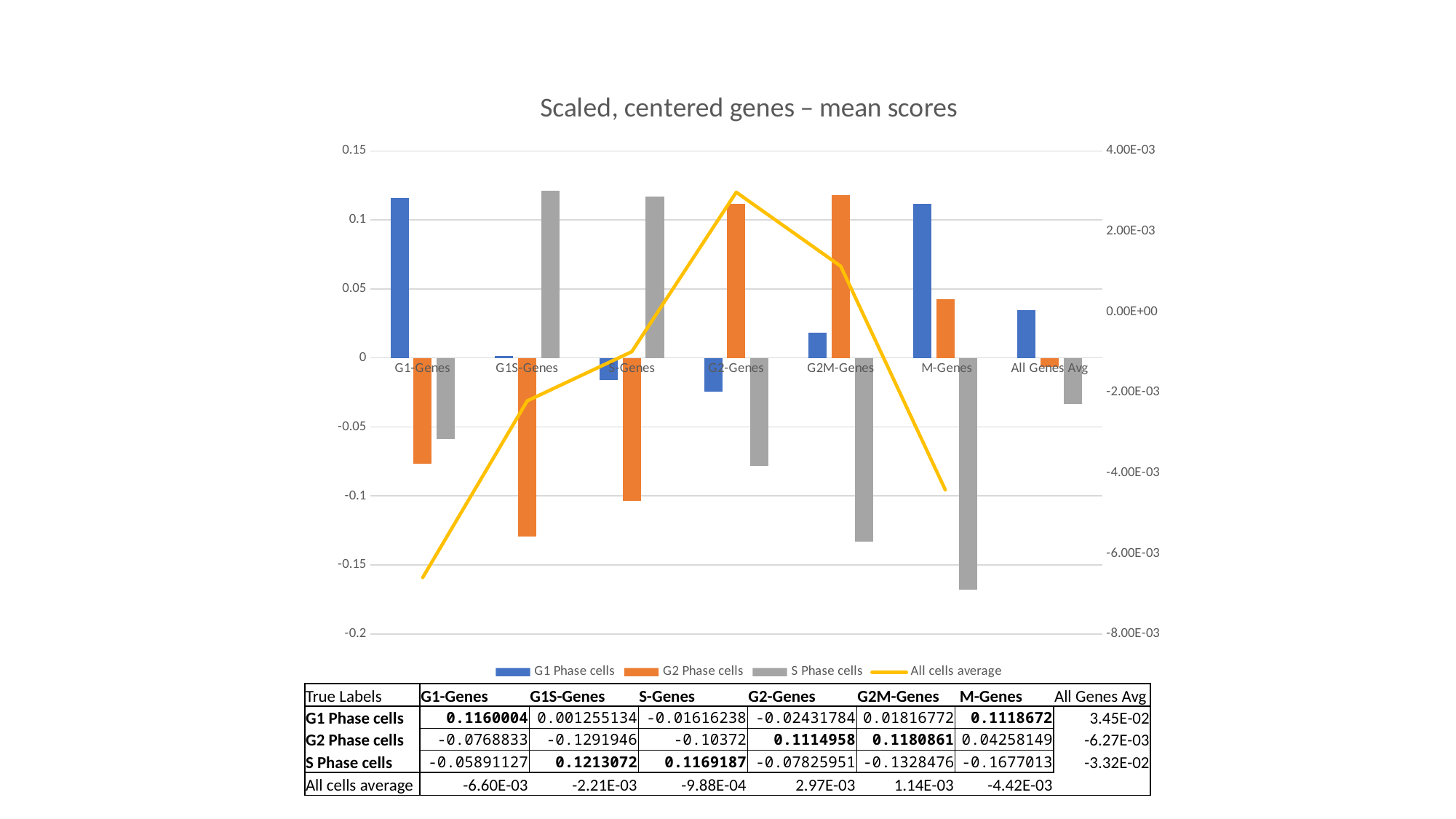
Is the value for S Phase cells at M-Genes greater or less than -0.15? less How many series does the chart legend list? 4 For the G2 Phase cells series, which category has the highest value? G2M-Genes What is the All cells average value at G2-Genes? 2.97E-03 How many categories are shown along the x axis of the chart? 7 What is the value for G1 Phase cells at G1-Genes? 0.1160004 What is the value for S Phase cells at M-Genes? -0.1677013 What is the difference between the G1 Phase cells values at G1-Genes and M-Genes? 0.0041332 What colour represents the S Phase cells series in the chart? Grey For the S Phase cells series, which category has the lowest value? M-Genes Which is larger for G2 Phase cells: the value at G2-Genes or at G2M-Genes? G2M-Genes What is the title of the chart? Scaled, centered genes – mean scores